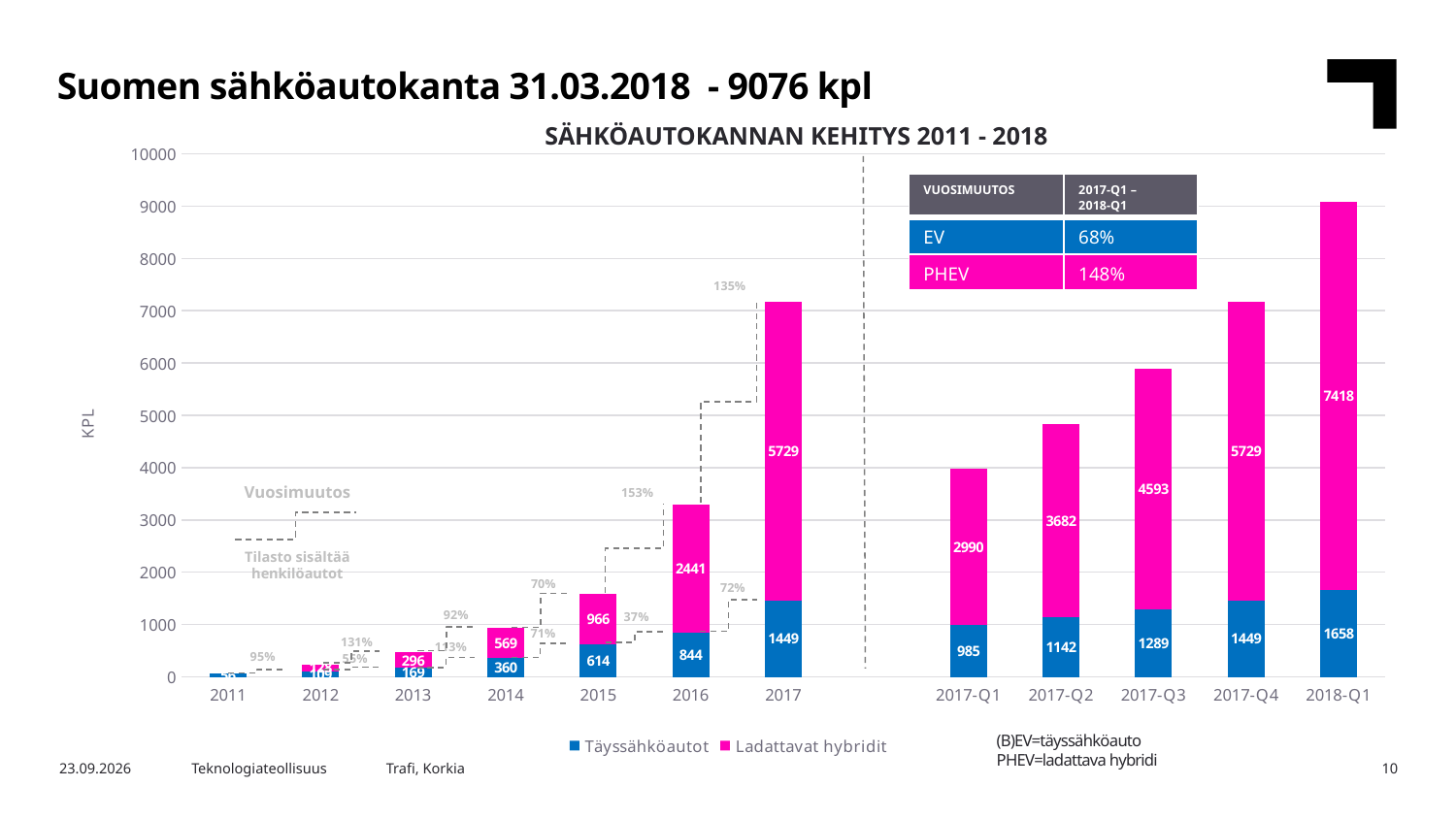
Which category has the highest Ladattavat hybridit value? 2018-Q1 According to the table on the chart, what is the year-on-year change (vuosimuutos) for PHEV from 2017-Q1 to 2018-Q1? 148% What is the total of the stacked bar for 2018-Q1? 9076 What is the value of Ladattavat hybridit for 2017-Q2? 3682 What is the total of the stacked bar for 2017? 7178 What type of chart is shown on the slide? Stacked bar chart What is the value of Täyssähköautot for 2016? 844 What is the difference between the Ladattavat hybridit values for 2017-Q4 and 2017-Q3? 1136 Is the total of the stacked bar for 2017-Q3 greater or less than 5000? greater What is the value of Ladattavat hybridit for 2018-Q1? 7418 Which is larger, the Täyssähköautot value for 2015 or for 2017-Q1? 2017-Q1 How many series does the legend list? 2